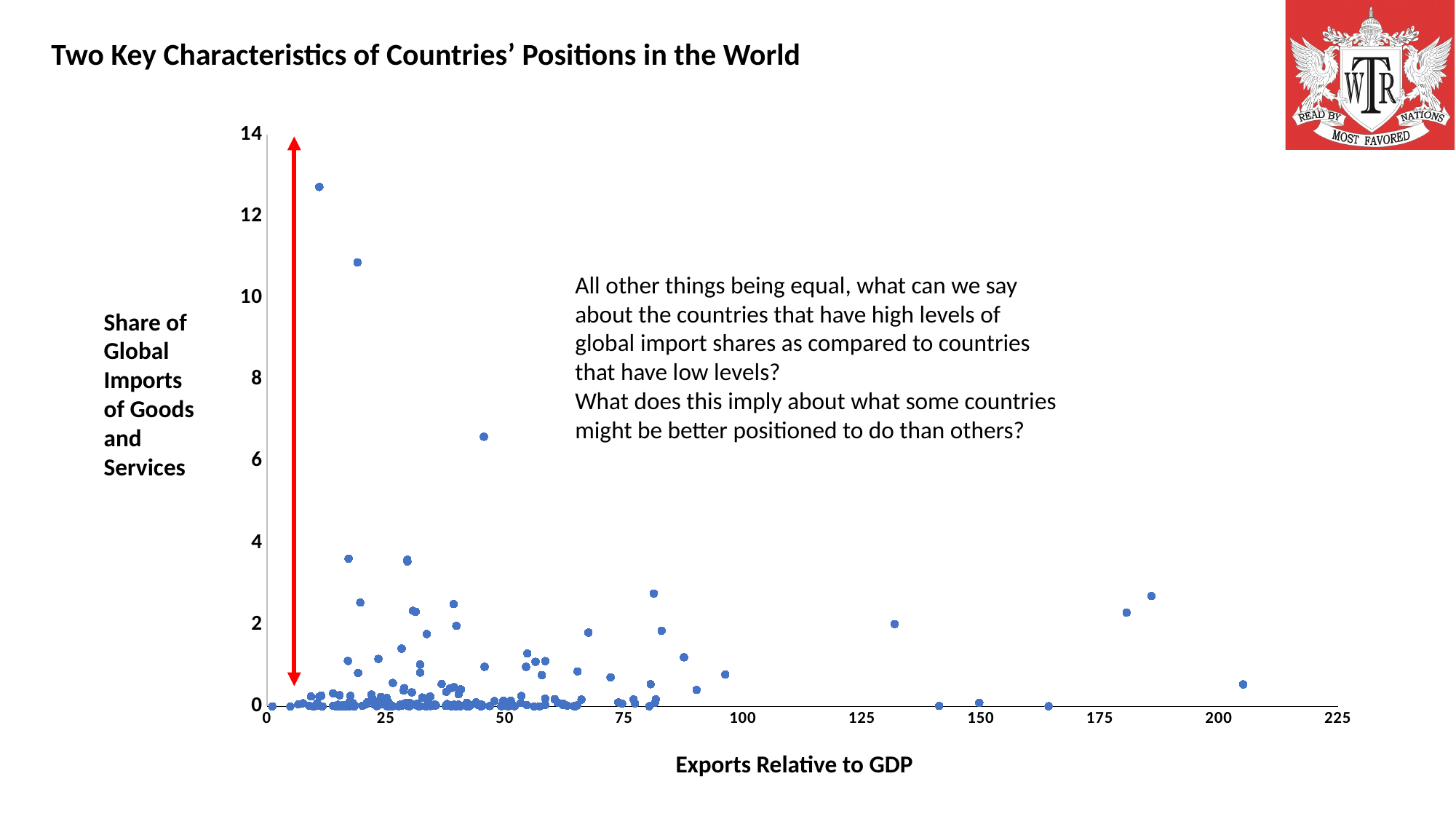
Is the x value of the highest point on the chart greater or less than 25? less Is the y value of the point near x = 132 greater or less than 4? less Is the x value of the rightmost point on the chart greater or less than 200? greater What is the title of the y axis of the chart? Share of Global Imports of Goods and Services What is the title of the x axis of the chart? Exports Relative to GDP What is the largest value shown on the y axis of the chart? 14 What is the largest value shown on the x axis of the chart? 225 What kind of chart is shown on the slide? scatter chart